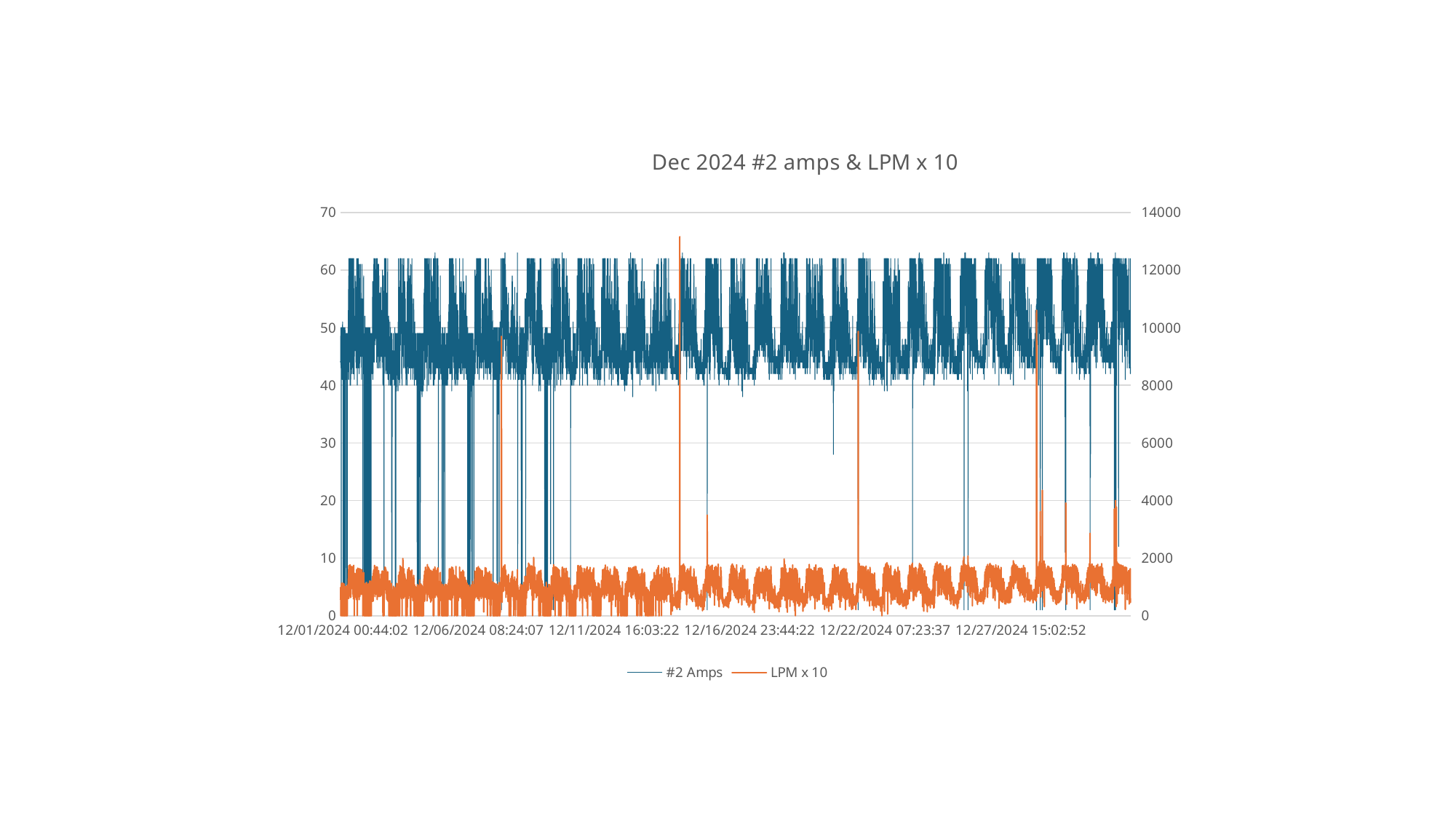
Which series is drawn in orange? LPM x 10 Is the typical level of the LPM x 10 series greater or less than 4000 on the right axis? less Is the highest value of the #2 Amps series greater or less than 70 on the left axis? less What is the title of the chart? Dec 2024 #2 amps & LPM x 10 What kind of chart is shown on the slide? line chart Is the highest spike of the LPM x 10 series greater or less than 12000 on the right axis? greater How many series does the legend list? 2